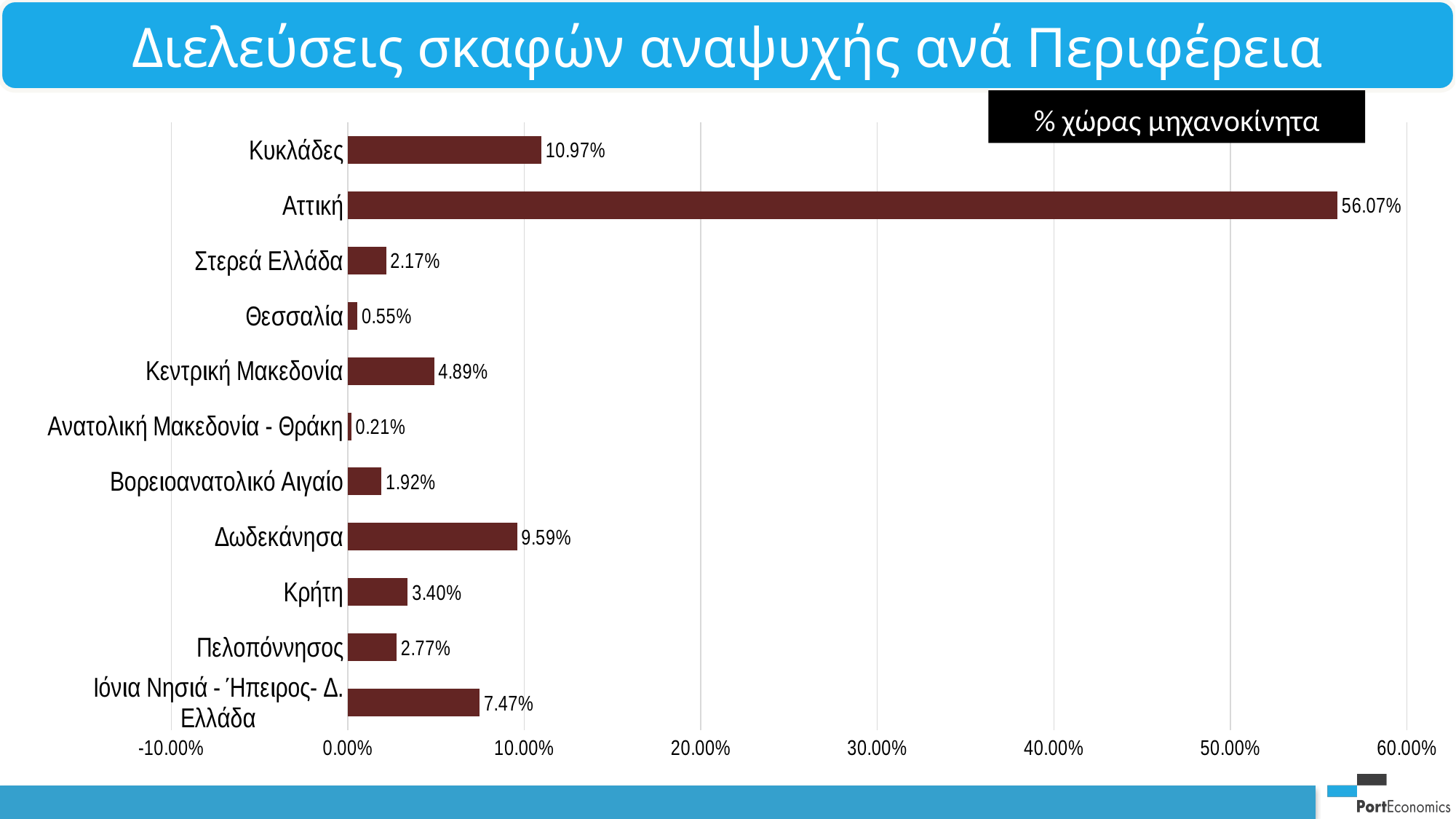
What is the value for Κρήτη? 3.40% How many regions are shown in the chart? 11 What is the value for Δωδεκάνησα? 9.59% Which is larger, the value for Κεντρική Μακεδονία or the value for Πελοπόννησος? Κεντρική Μακεδονία What is the difference between the values for Δωδεκάνησα and Ιόνια Νησιά - Ήπειρος- Δ. Ελλάδα? 2.12% What kind of chart is shown on the slide? Bar chart Which region has the highest value? Αττική What is the value for Κυκλάδες? 10.97% What is the title of the slide? Διελεύσεις σκαφών αναψυχής ανά Περιφέρεια What is the difference between the values for Αττική and Κυκλάδες? 45.10% Which region has the lowest value? Ανατολική Μακεδονία - Θράκη What is the value for Αττική? 56.07%